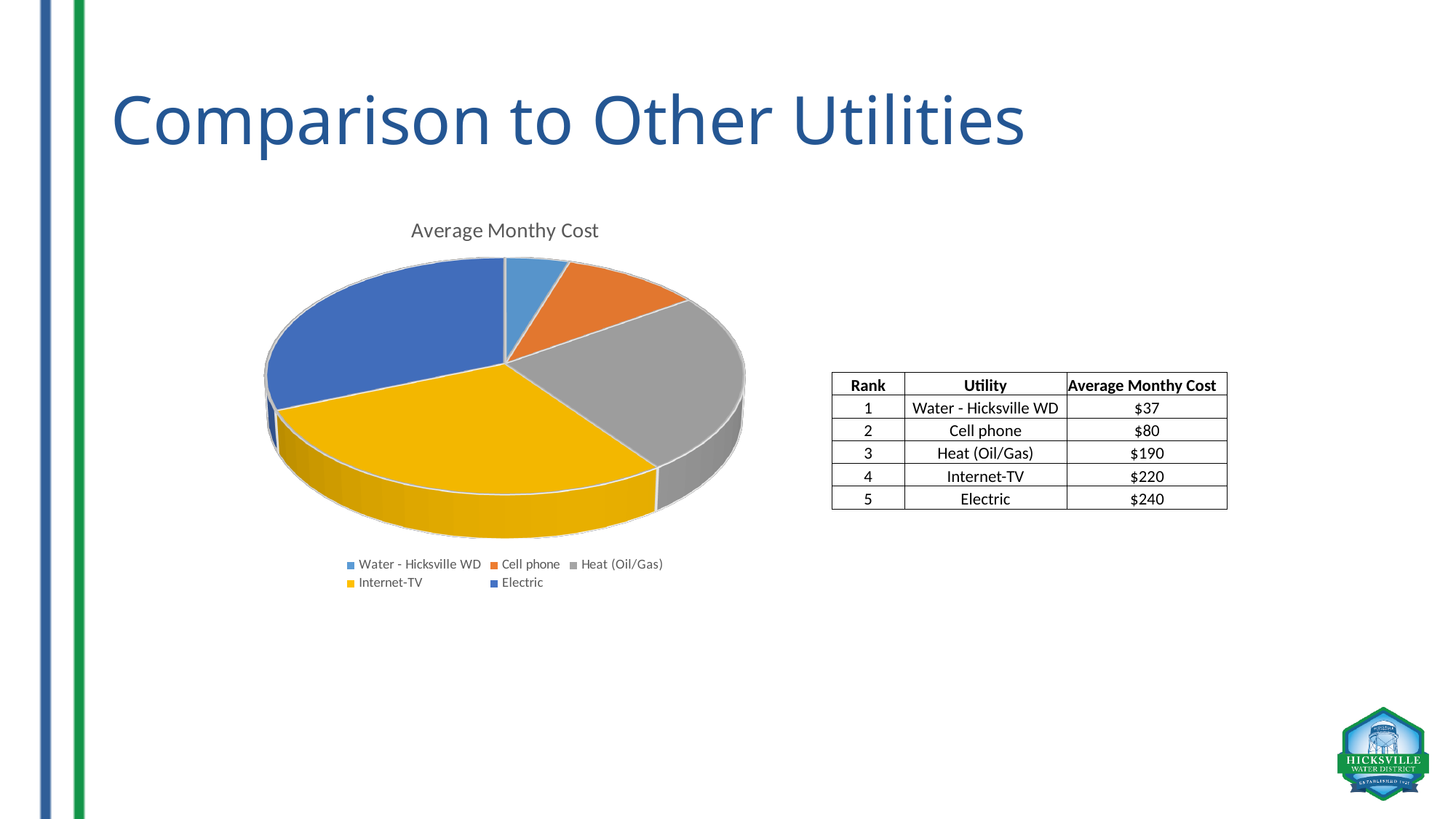
Which has a larger average monthly cost, Cell phone or Heat (Oil/Gas)? Heat (Oil/Gas) What is the average monthly cost for Internet-TV? $220 What is the average monthly cost for Water - Hicksville WD? $37 What is the average monthly cost for Heat (Oil/Gas)? $190 What is the average monthly cost for Electric? $240 Which utility has the highest average monthly cost? Electric What is the difference in average monthly cost between Electric and Water - Hicksville WD? $203 What is the title of the chart? Average Monthy Cost What is the difference in average monthly cost between Internet-TV and Heat (Oil/Gas)? $30 What kind of chart is shown on the slide? Pie chart Which utility has the lowest average monthly cost? Water - Hicksville WD How many utilities are shown in the pie chart? 5